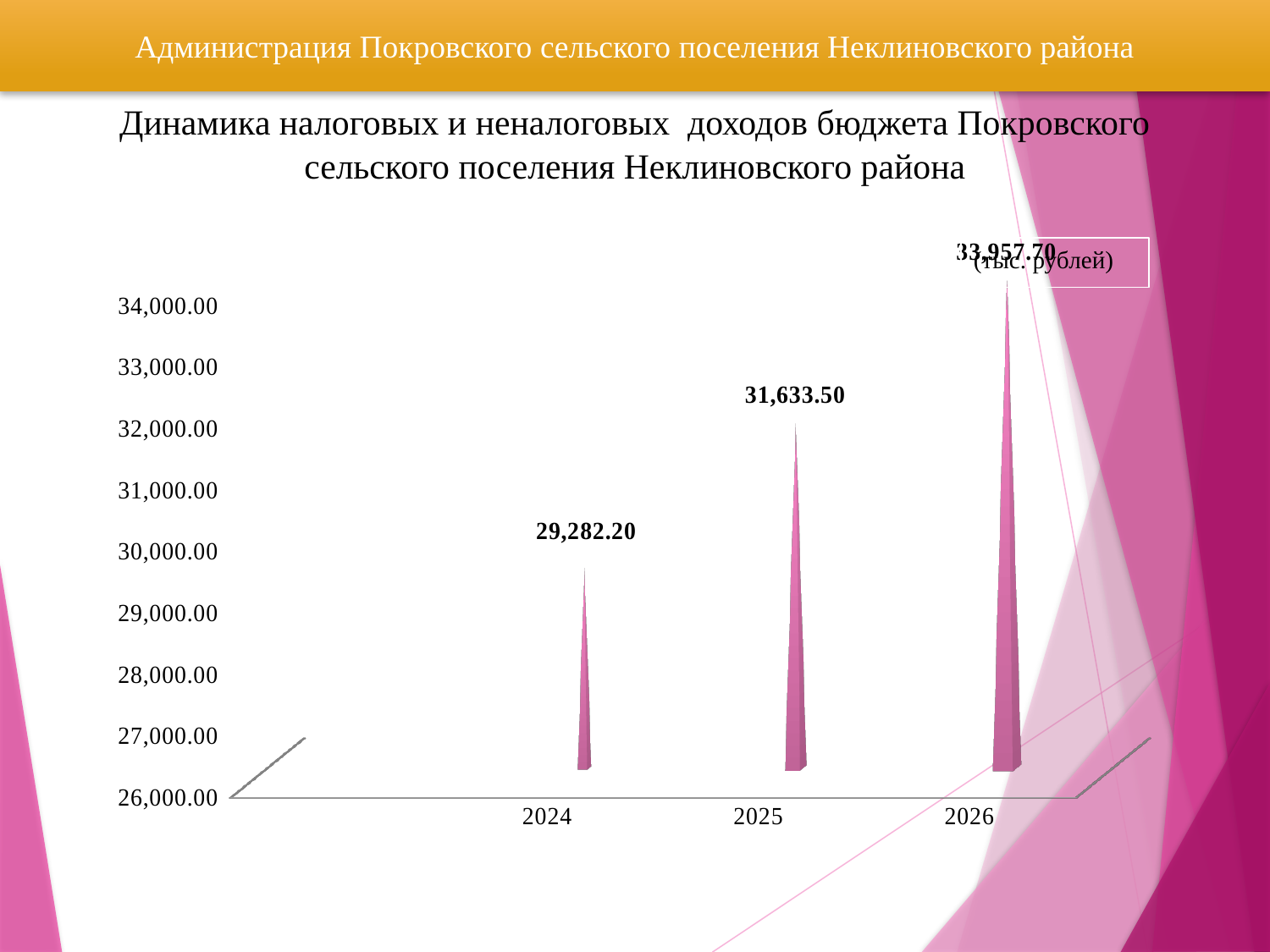
Do the values rise or fall from 2024 to 2026? rise What is the difference between the values for 2025 and 2024? 2,351.30 Is the value for 2026 greater or less than 33,000.00? greater What is the value for 2026? 33,957.70 What is the difference between the values for 2026 and 2025? 2,324.20 Which year has the highest value? 2026 In what units are the values given, according to the label on the chart? тыс. рублей What is the value for 2024? 29,282.20 How many years are shown on the x axis? 3 Which year has the lowest value? 2024 Which is larger, the value for 2024 or the value for 2025? 2025 What is the value for 2025? 31,633.50